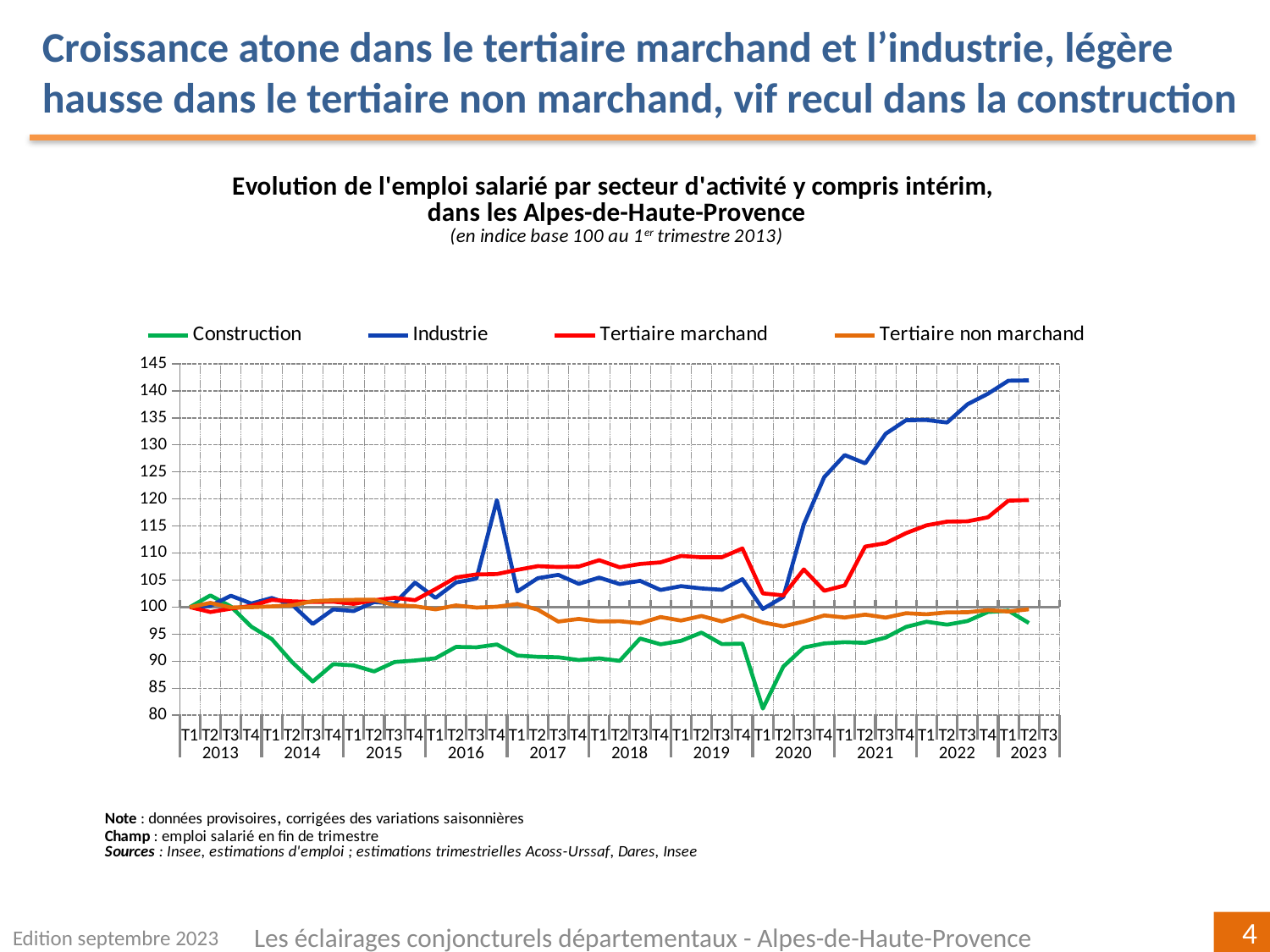
How many years are labelled on the x axis? 11 How many series does the legend list? 4 Which series has the lowest value at T1 2020? Construction Is the value for Construction at T1 2020 greater or less than 85? less What colour is the Industrie line in the chart? Blue What kind of chart is shown on the slide? Line chart